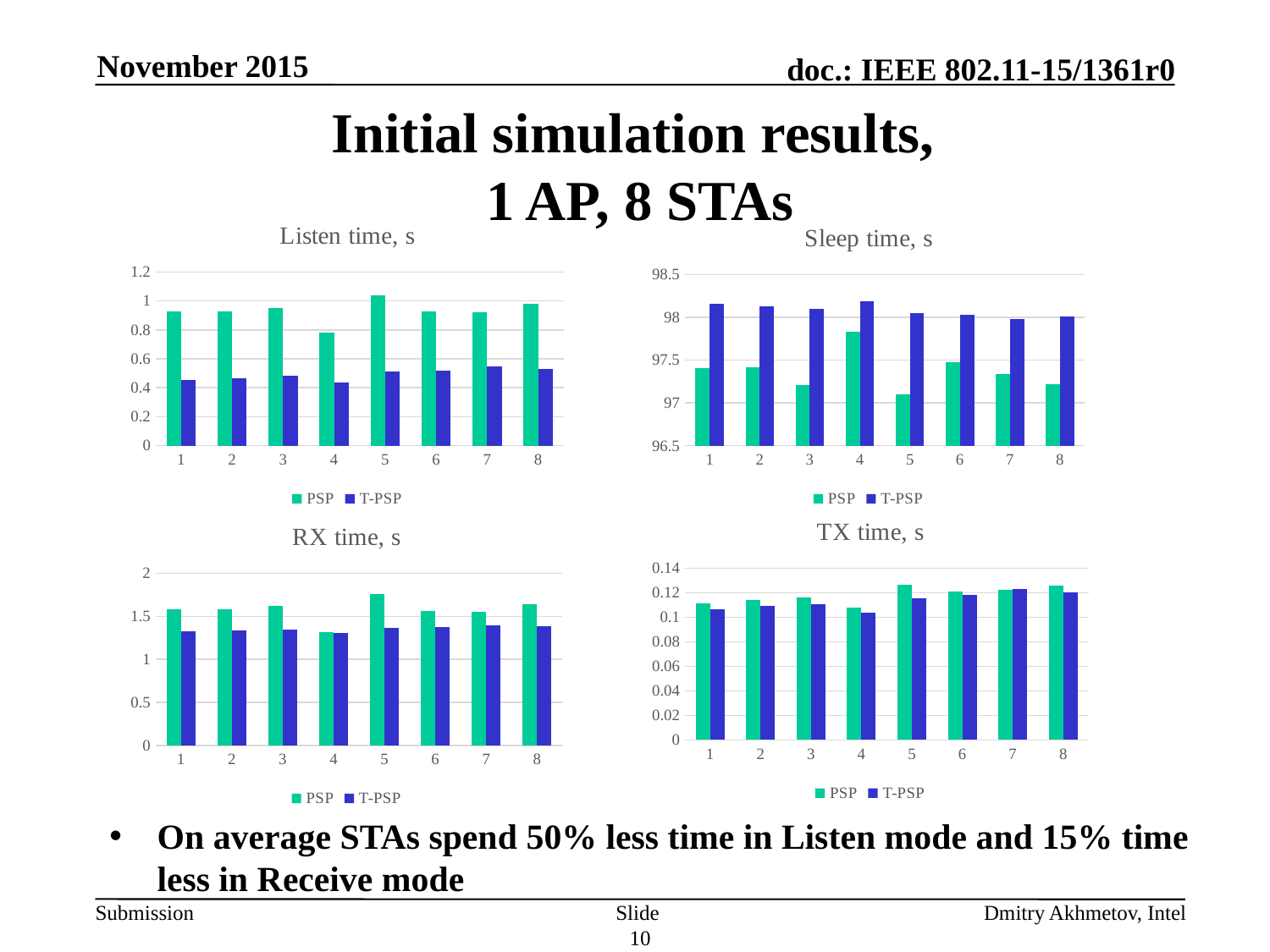
In the Sleep time, s chart, for category 3, which series has the larger value, PSP or T-PSP? T-PSP In the Listen time, s chart, is the PSP value for category 5 greater or less than 1? greater In the Sleep time, s chart, is the T-PSP value for category 1 greater or less than 98? greater In the Listen time, s chart, which category has the highest PSP value? 5 How many categories are shown on the x axis of the RX time, s chart? 8 In the Listen time, s chart, which category has the lowest PSP value? 4 In the RX time, s chart, which category has the highest PSP value? 5 In the Sleep time, s chart, which category has the highest PSP value? 4 In the Listen time, s chart, for category 1, which series has the larger value, PSP or T-PSP? PSP How many series does the legend of the TX time, s chart list? 2 In the RX time, s chart, is the T-PSP value for category 4 greater or less than 1.5? less